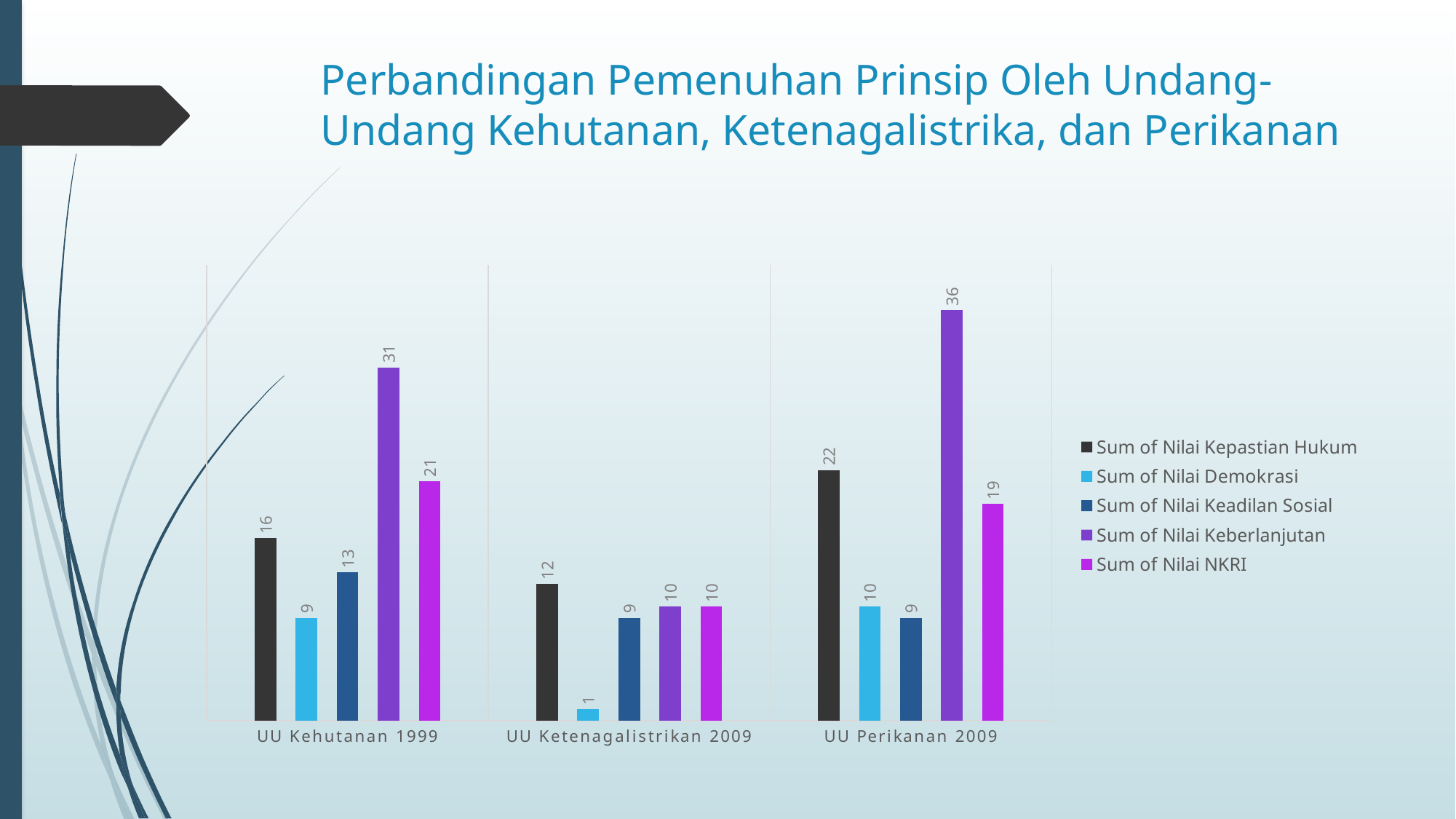
What is the difference between Sum of Nilai Keberlanjutan for UU Perikanan 2009 and for UU Kehutanan 1999? 5 What kind of chart is shown on the slide? Bar chart Which series is shown in magenta in the legend? Sum of Nilai NKRI How many categories are shown on the x axis? 3 What is the value of Sum of Nilai Keberlanjutan for UU Kehutanan 1999? 31 Which category has the highest value for Sum of Nilai Keberlanjutan? UU Perikanan 2009 Which category has the lowest value for Sum of Nilai NKRI? UU Ketenagalistrikan 2009 What is the value of Sum of Nilai Keadilan Sosial for UU Kehutanan 1999? 13 What is the value of Sum of Nilai Kepastian Hukum for UU Perikanan 2009? 22 How many series does the legend list? 5 Which is larger: Sum of Nilai Keadilan Sosial for UU Kehutanan 1999 or for UU Perikanan 2009? UU Kehutanan 1999 What is the value of Sum of Nilai Demokrasi for UU Ketenagalistrikan 2009? 1